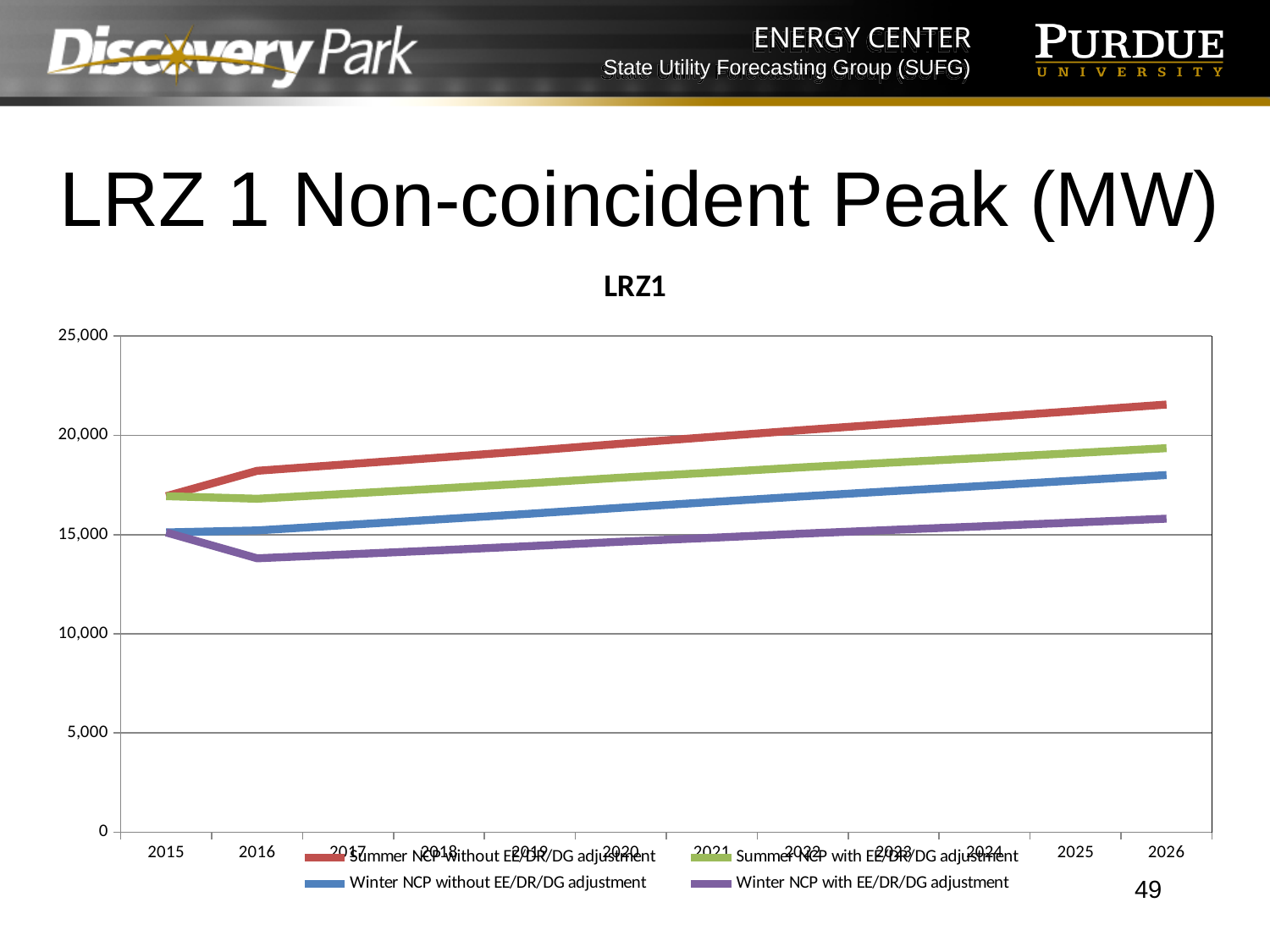
What kind of chart is shown on the slide? Line chart What is the title shown above the chart's plot area? LRZ1 Is the value for Winter NCP with EE/DR/DG adjustment in 2016 greater or less than 15,000? less Which series is drawn in red in the chart? Summer NCP without EE/DR/DG adjustment Which series has the lowest value in 2026? Winter NCP with EE/DR/DG adjustment Is the value for Winter NCP without EE/DR/DG adjustment in 2026 greater or less than 15,000? greater In 2016, which is larger: Winter NCP without EE/DR/DG adjustment or Winter NCP with EE/DR/DG adjustment? Winter NCP without EE/DR/DG adjustment Does the Summer NCP without EE/DR/DG adjustment line rise or fall from 2015 to 2026? Rise Is the value for Summer NCP without EE/DR/DG adjustment in 2026 greater or less than 20,000? greater How many years are shown along the x axis of the chart? 12 Which series has the highest value in 2026? Summer NCP without EE/DR/DG adjustment How many series does the chart legend list? 4